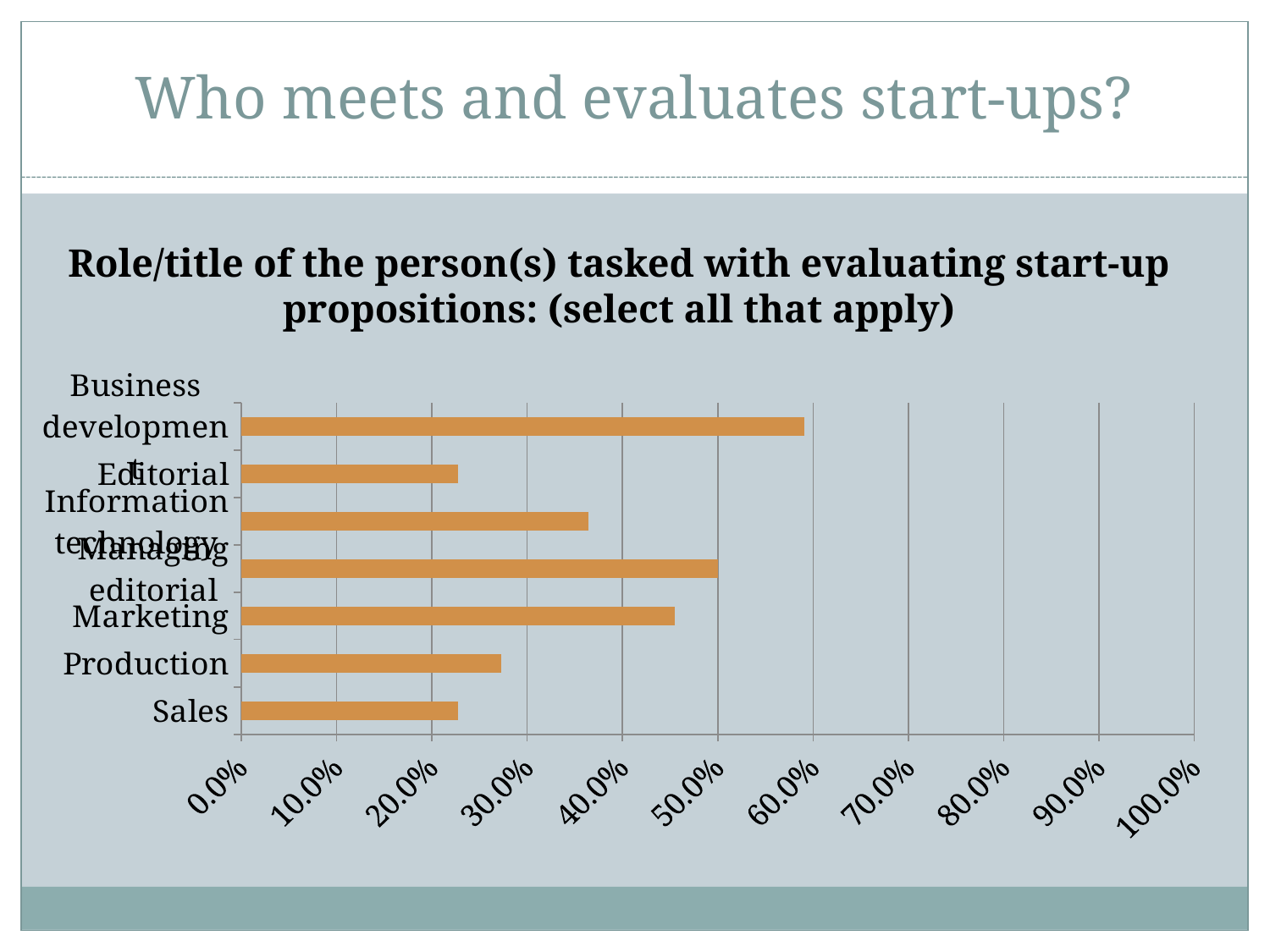
Which has a larger value, Marketing or Production? Marketing Is the value for Marketing greater or less than 40.0%? greater How many roles/categories are plotted in the chart? 7 Is the value for Information technology greater or less than 30.0%? greater Which has a larger value, Business development or Managing editorial? Business development Which has a larger value, Information technology or Sales? Information technology Is the value for Production greater or less than 30.0%? less Which role has the highest value in the chart? Business development What is the maximum value shown on the horizontal axis of the chart? 100.0% What kind of chart is shown on the slide? bar chart